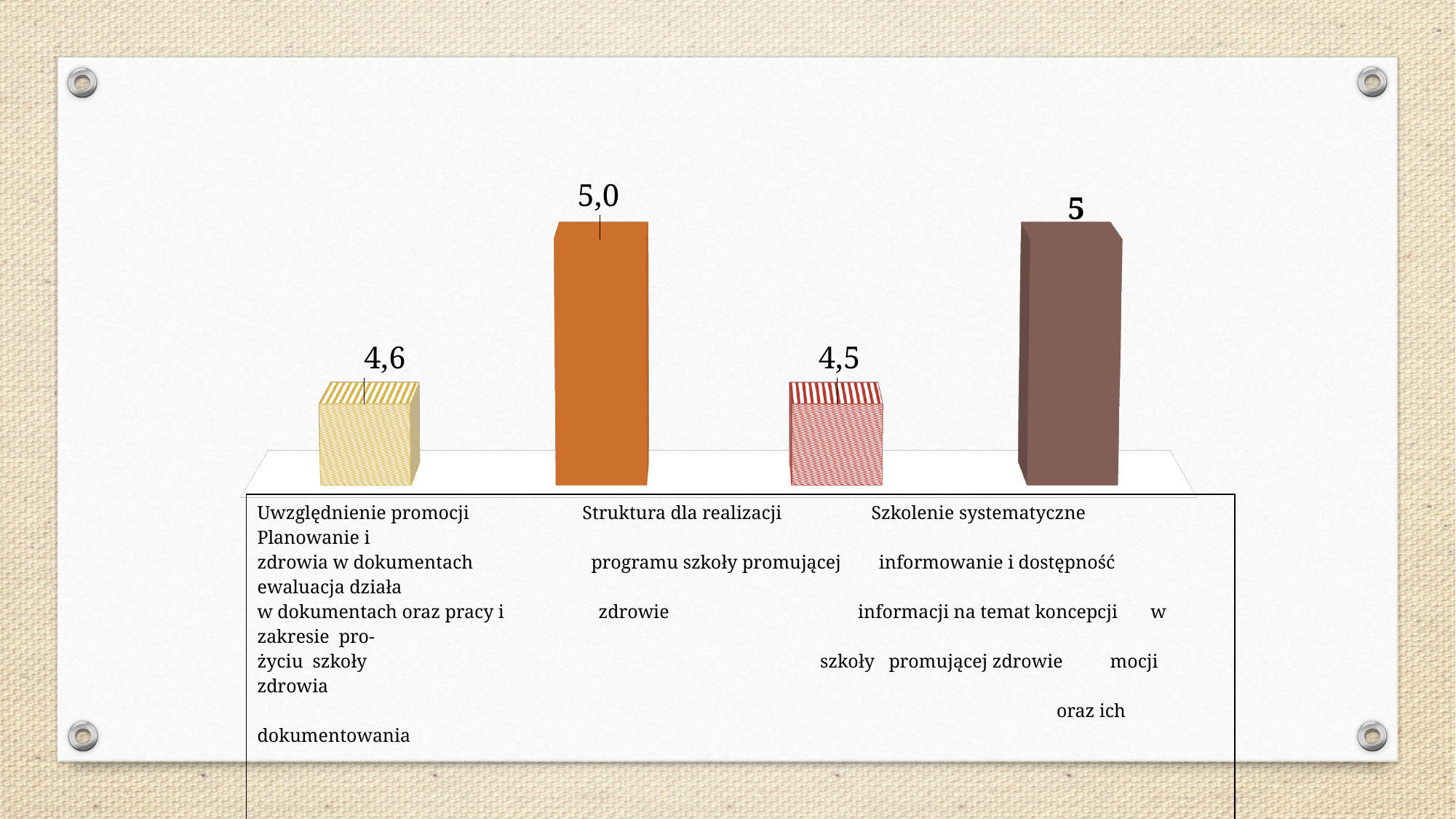
What colour is the second bar, "Struktura dla realizacji programu szkoły promującej zdrowie"? Orange What value is shown for the third bar, "Szkolenie systematyczne informowanie i dostępność informacji"? 4,5 Which bar has the lowest value? Szkolenie systematyczne informowanie i dostępność informacji (third bar) What value is shown for the first (leftmost) bar, "Uwzględnienie promocji zdrowia w dokumentach"? 4,6 What value is shown for the bar labelled "Struktura dla realizacji programu szkoły promującej zdrowie"? 5,0 Which is larger: the value for "Struktura dla realizacji programu szkoły promującej zdrowie" or the value for "Uwzględnienie promocji zdrowia w dokumentach"? Struktura dla realizacji programu szkoły promującej zdrowie What value is shown for the fourth (rightmost) bar? 5 Which is larger: the value of the fourth bar or the value of the third bar? The fourth bar What kind of chart is shown on the slide? Bar chart What is the difference between the value of the first bar (4,6) and the third bar (4,5)? 0,1 How many bars are plotted in the chart? 4 What is the difference between the value of the second bar (5,0) and the first bar (4,6)? 0,4